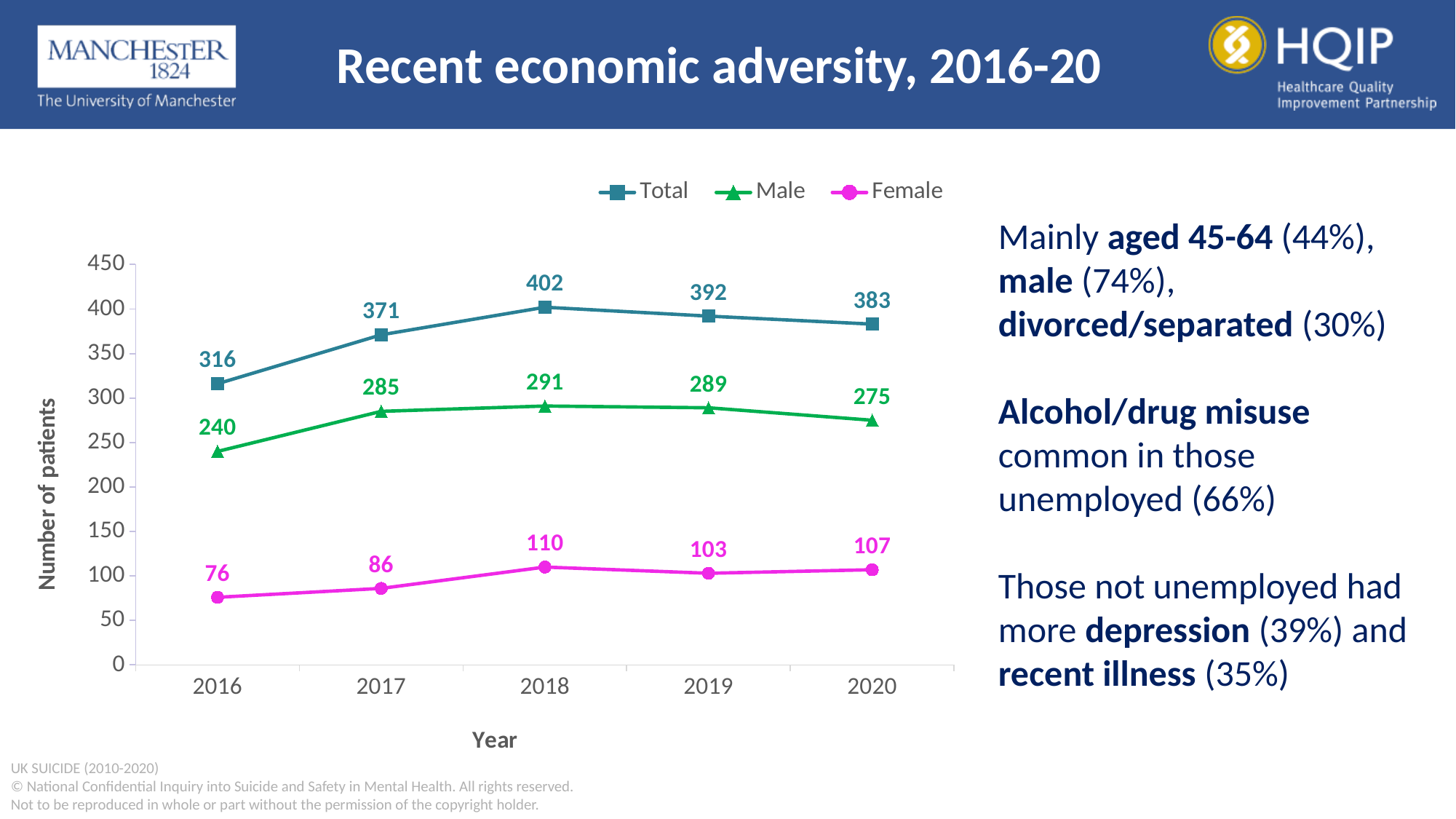
How many years are shown on the x axis? 5 Is the Male value for 2018 greater or less than 250? greater In which year is the Total series highest? 2018 What is the label of the y axis? Number of patients What is the Male value for 2020? 275 In which year is the Female series lowest? 2016 What is the Total value for 2018? 402 What is the Female value for 2016? 76 How many series does the legend list? 3 What kind of chart is shown on the slide? line chart Which is larger, the Total value for 2019 or the Total value for 2020? 2019 What is the difference between the Male values for 2017 and 2016? 45